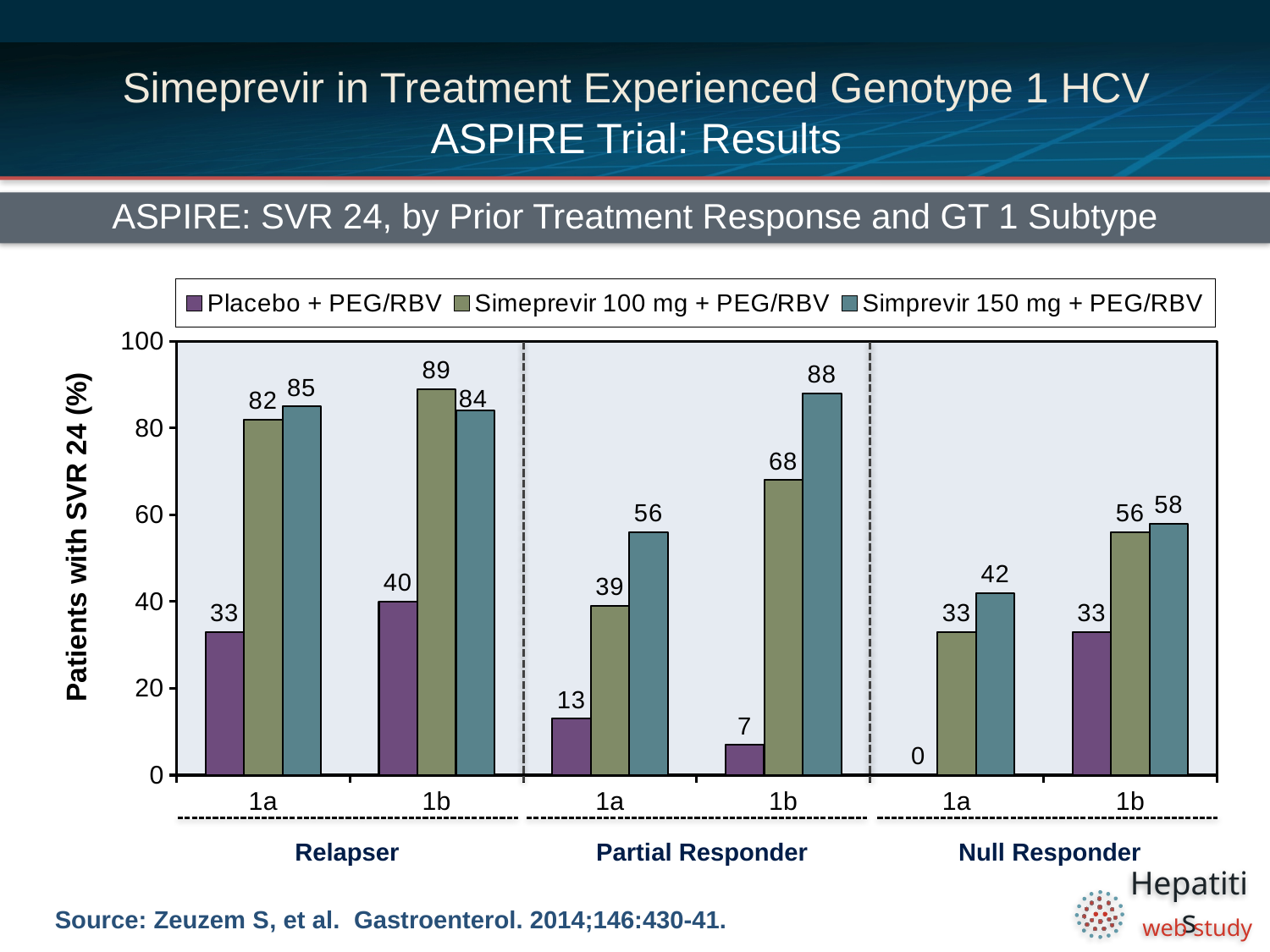
What is the SVR 24 value for Placebo + PEG/RBV in Relapser genotype 1a patients? 33 In Relapser genotype 1b patients, which is larger: the Simeprevir 100 mg + PEG/RBV value or the Simprevir 150 mg + PEG/RBV value? Simeprevir 100 mg + PEG/RBV What is the SVR 24 value for Simeprevir 100 mg + PEG/RBV in Relapser genotype 1b patients? 89 How many genotype subtype groups are shown along the x axis? 6 Which group has the highest SVR 24 value for Simeprevir 100 mg + PEG/RBV? Relapser 1b Which group has the lowest SVR 24 value for Placebo + PEG/RBV? Null Responder 1a What is the label of the y axis? Patients with SVR 24 (%) What kind of chart is shown on the slide? Bar chart How many series does the legend list? 3 What is the SVR 24 value for Placebo + PEG/RBV in Null Responder genotype 1a patients? 0 What is the SVR 24 value for Simprevir 150 mg + PEG/RBV in Partial Responder genotype 1b patients? 88 What is the difference between the Simprevir 150 mg + PEG/RBV and Placebo + PEG/RBV values in Partial Responder genotype 1a patients? 43